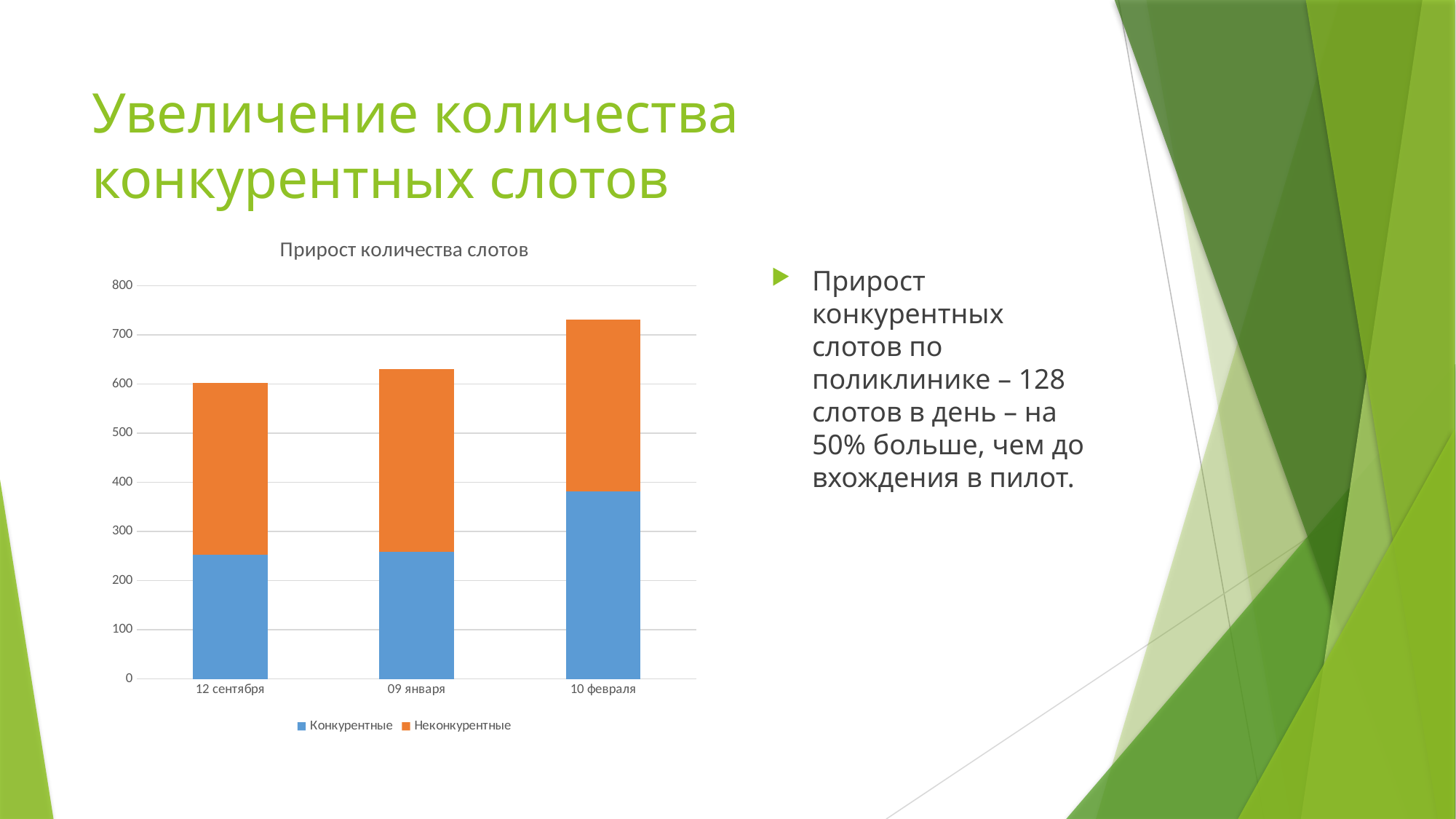
What is the title of the chart? Прирост количества слотов How many series does the legend list? 2 Is the value for Конкурентные on 12 сентября greater or less than 300? less Is the value for Конкурентные on 10 февраля greater or less than 300? greater Which date has the tallest stacked bar in total? 10 февраля How many dates are shown on the x axis of the chart? 3 Which date has the shortest stacked bar in total? 12 сентября What kind of chart is shown on the slide? Stacked bar chart Is the total height of the stacked bar for 10 февраля greater or less than 700? greater Which series is shown in orange in the chart? Неконкурентные Do the total bar heights rise or fall from 12 сентября to 10 февраля? rise Which date has the highest value for Конкурентные? 10 февраля